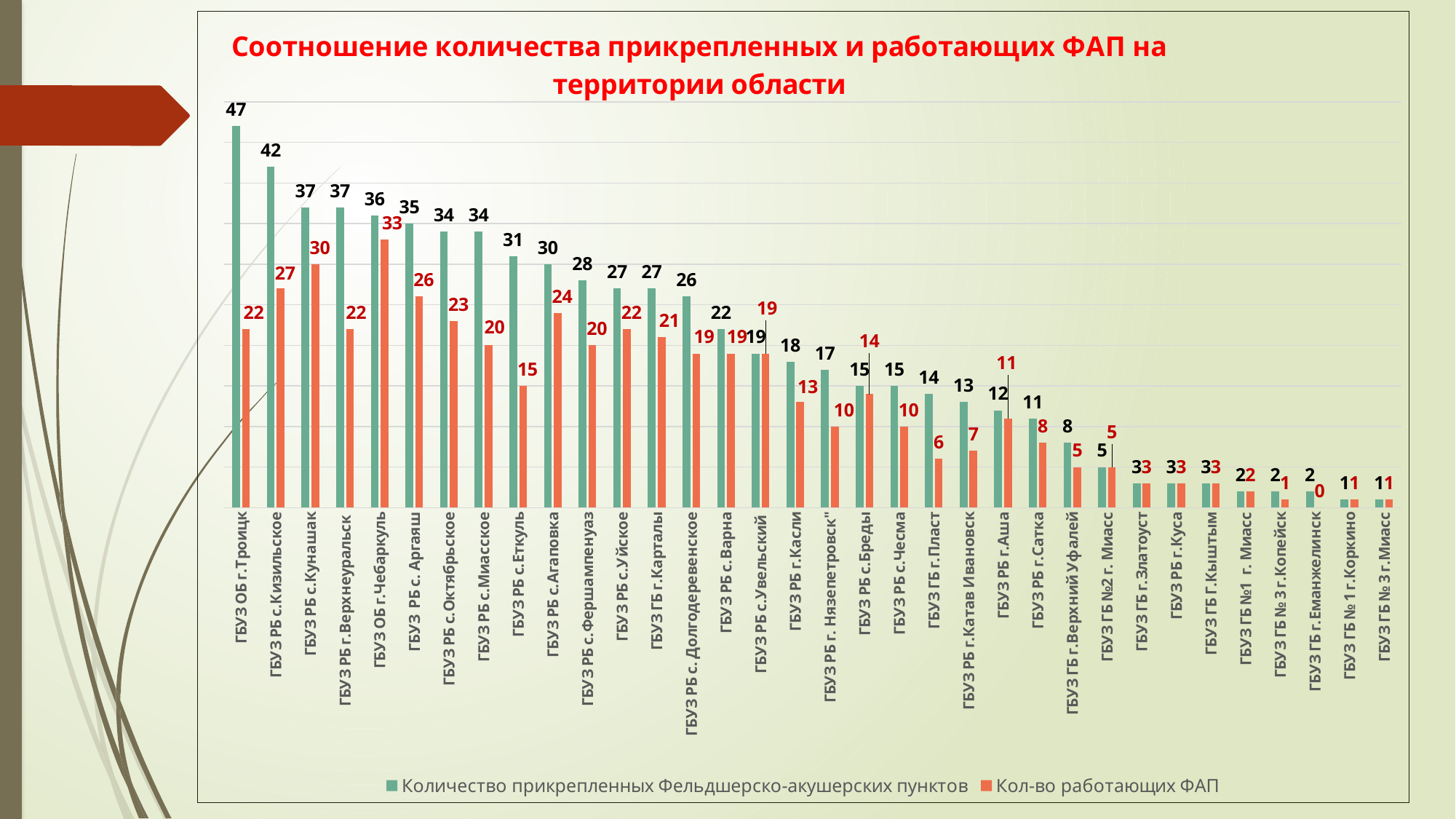
What is the number of working FAPs (Кол-во работающих ФАП) for ГБУЗ ОБ г.Чебаркуль? 33 Which organisation has the lowest number of working FAPs? ГБУЗ ГБ г.Еманжелинск Do the values for attached FAPs rise or fall from left to right along the x axis? Fall What is the number of attached FAPs (Количество прикрепленных Фельдшерско-акушерских пунктов) for ГБУЗ ОБ г.Троицк? 47 How many organisations are shown on the x axis? 34 What is the difference between attached and working FAPs for ГБУЗ ОБ г.Троицк? 25 Which organisation has the highest number of attached FAPs? ГБУЗ ОБ г.Троицк Which organisation has the highest number of working FAPs? ГБУЗ ОБ г.Чебаркуль What is the difference between attached and working FAPs for ГБУЗ РБ с.Еткуль? 16 How many series does the legend list? 2 What type of chart is shown on the slide? Bar chart Which has more working FAPs: ГБУЗ РБ с.Кунашак or ГБУЗ РБ г.Верхнеуральск? ГБУЗ РБ с.Кунашак